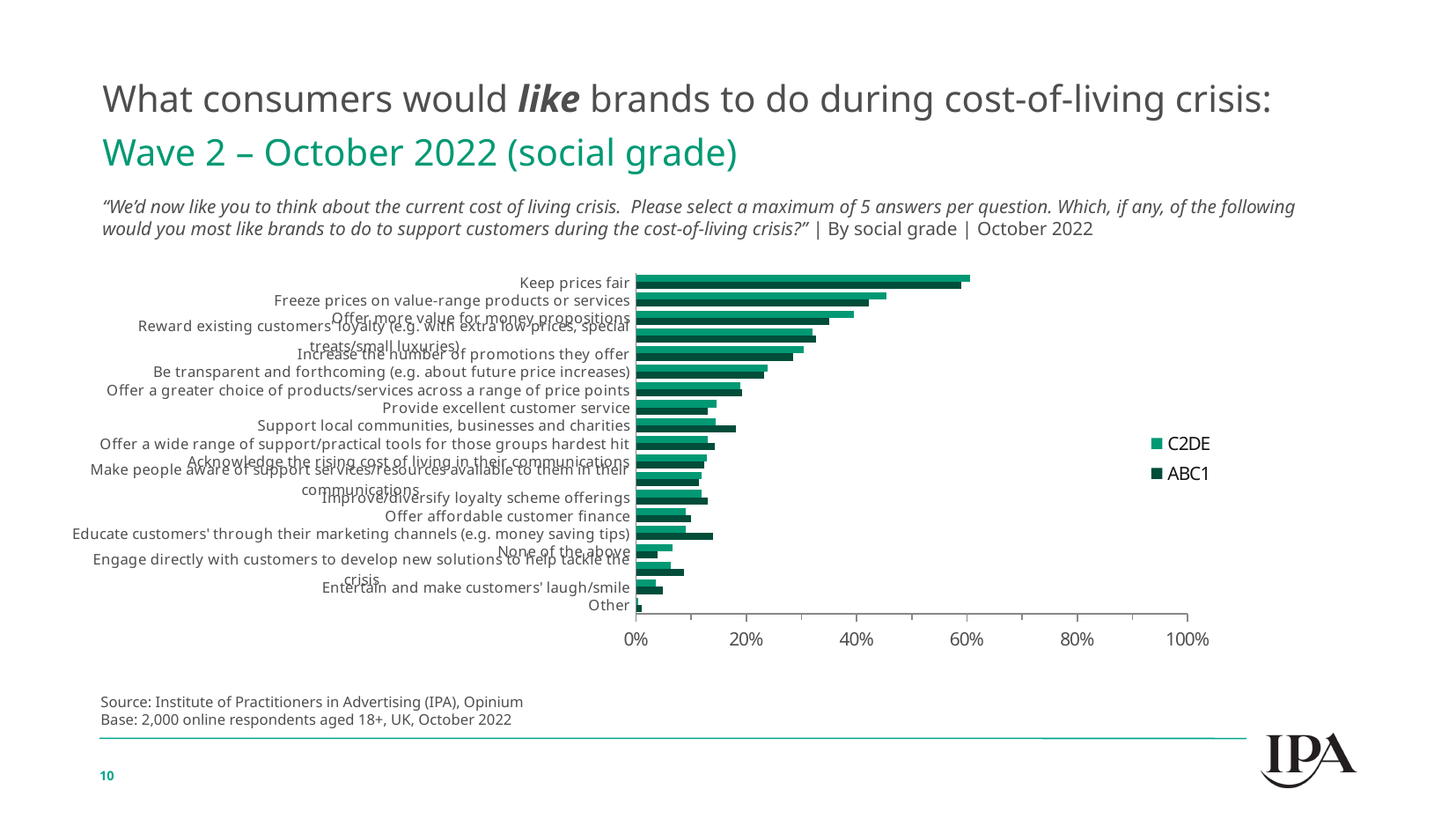
Is the ABC1 value for 'Other' greater or less than 20%? less For 'Support local communities, businesses and charities', which series has the larger value, C2DE or ABC1? ABC1 For 'Educate customers' through their marketing channels (e.g. money saving tips)', which series has the larger value, C2DE or ABC1? ABC1 Which category has the highest values for both series? Keep prices fair Which category has the lowest values for both series? Other Is the ABC1 value for 'Offer more value for money propositions' greater or less than 40%? less What kind of chart is shown on the slide? Bar chart What are the two series named in the legend? C2DE and ABC1 How many series does the legend list? 2 Is the C2DE value for 'Freeze prices on value-range products or services' greater or less than 40%? greater Which is larger: the C2DE value for 'Keep prices fair' or the C2DE value for 'Provide excellent customer service'? Keep prices fair